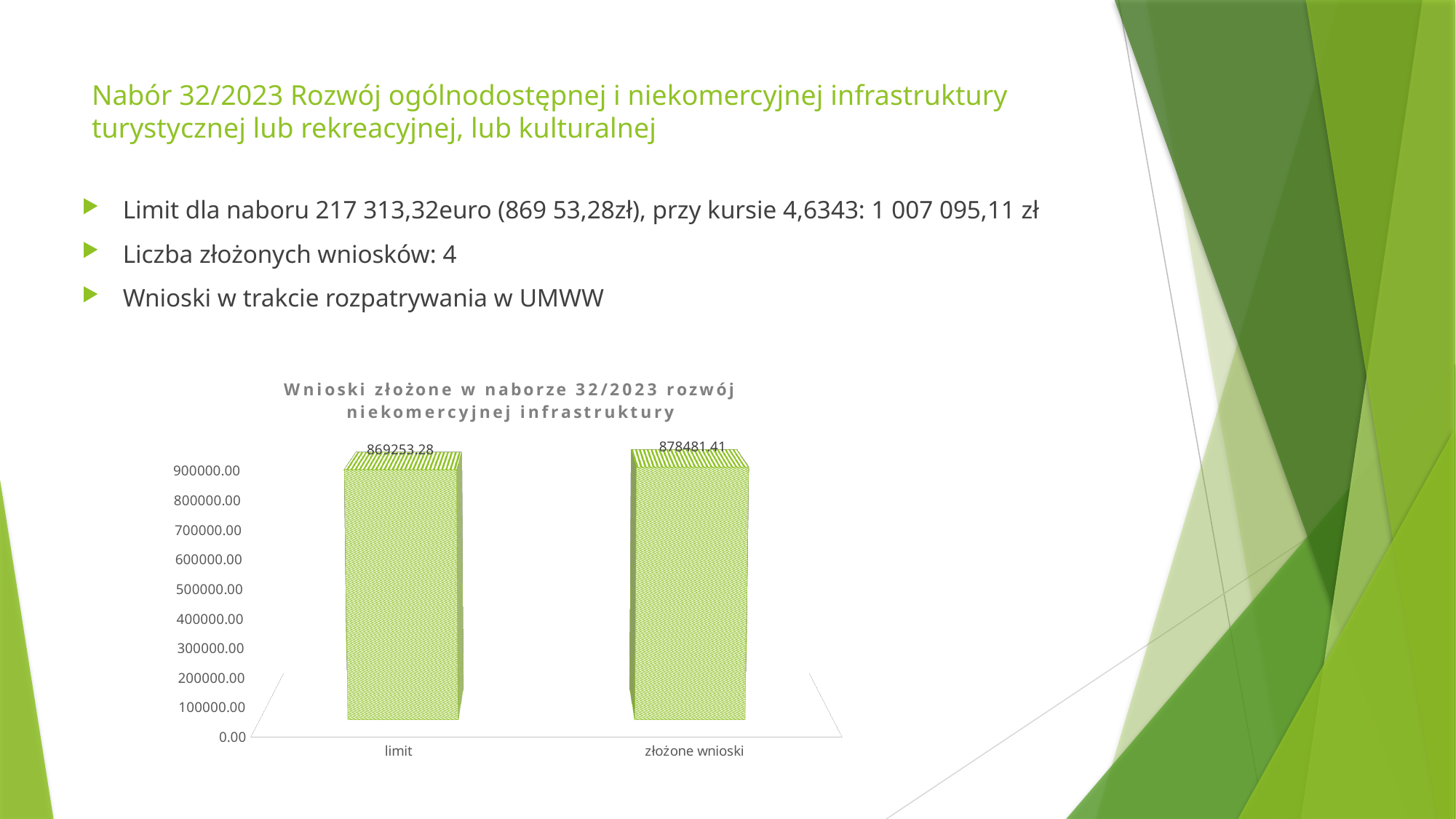
How many bars are shown in the chart? 2 Which category has the higher value in the chart, 'limit' or 'złożone wnioski'? złożone wnioski Is the value for 'złożone wnioski' greater or less than 500000.00? greater What is the value of the 'limit' bar in the chart? 869253.28 What is the title of the chart? Wnioski złożone w naborze 32/2023 rozwój niekomercyjnej infrastruktury Which category has the highest value in the chart? złożone wnioski Is the value for 'limit' greater or less than 800000.00? greater Which category has the lowest value in the chart? limit What is the value of the 'złożone wnioski' bar in the chart? 878481.41 What is the highest tick value shown on the vertical axis of the chart? 900000.00 What kind of chart is shown on the slide? bar chart What is the difference between the 'złożone wnioski' value and the 'limit' value in the chart? 9228.13